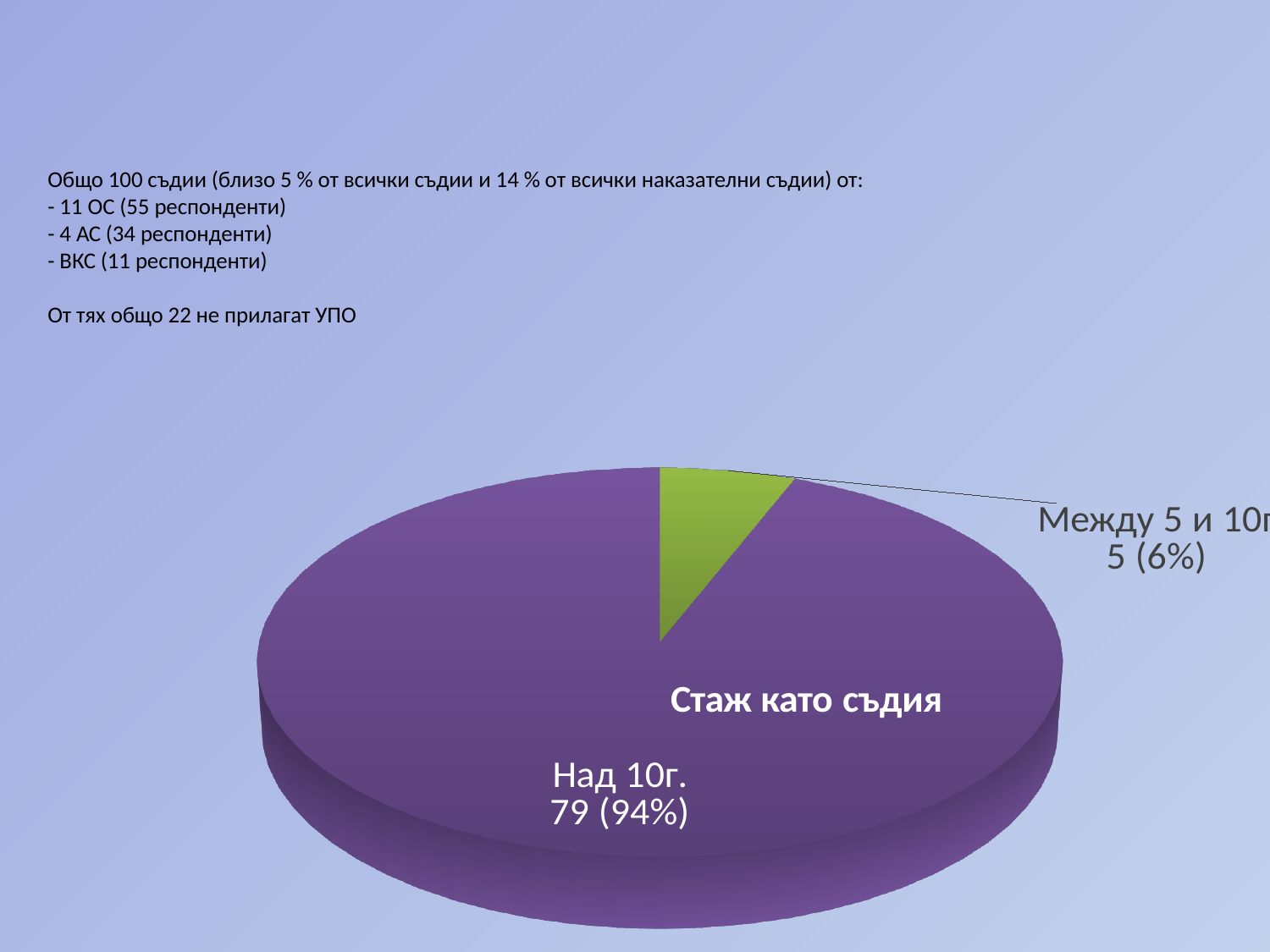
What colour is the "Между 5 и 10г" slice? Green What is the title of the pie chart? Стаж като съдия Which is larger, the "Над 10г." slice or the "Между 5 и 10г" slice? Над 10г. How many slices does the pie chart have? 2 What is the difference in count between the "Над 10г." slice and the "Между 5 и 10г" slice? 74 Which slice is the largest in the pie chart? Над 10г. What share of the pie does the "Между 5 и 10г" slice represent? 6% Which slice is the smallest in the pie chart? Между 5 и 10г What value is shown for the "Между 5 и 10г" slice? 5 (6%) What value is shown for the "Над 10г." slice? 79 (94%) What share of the pie does the "Над 10г." slice represent? 94% What kind of chart is shown on the slide? Pie chart